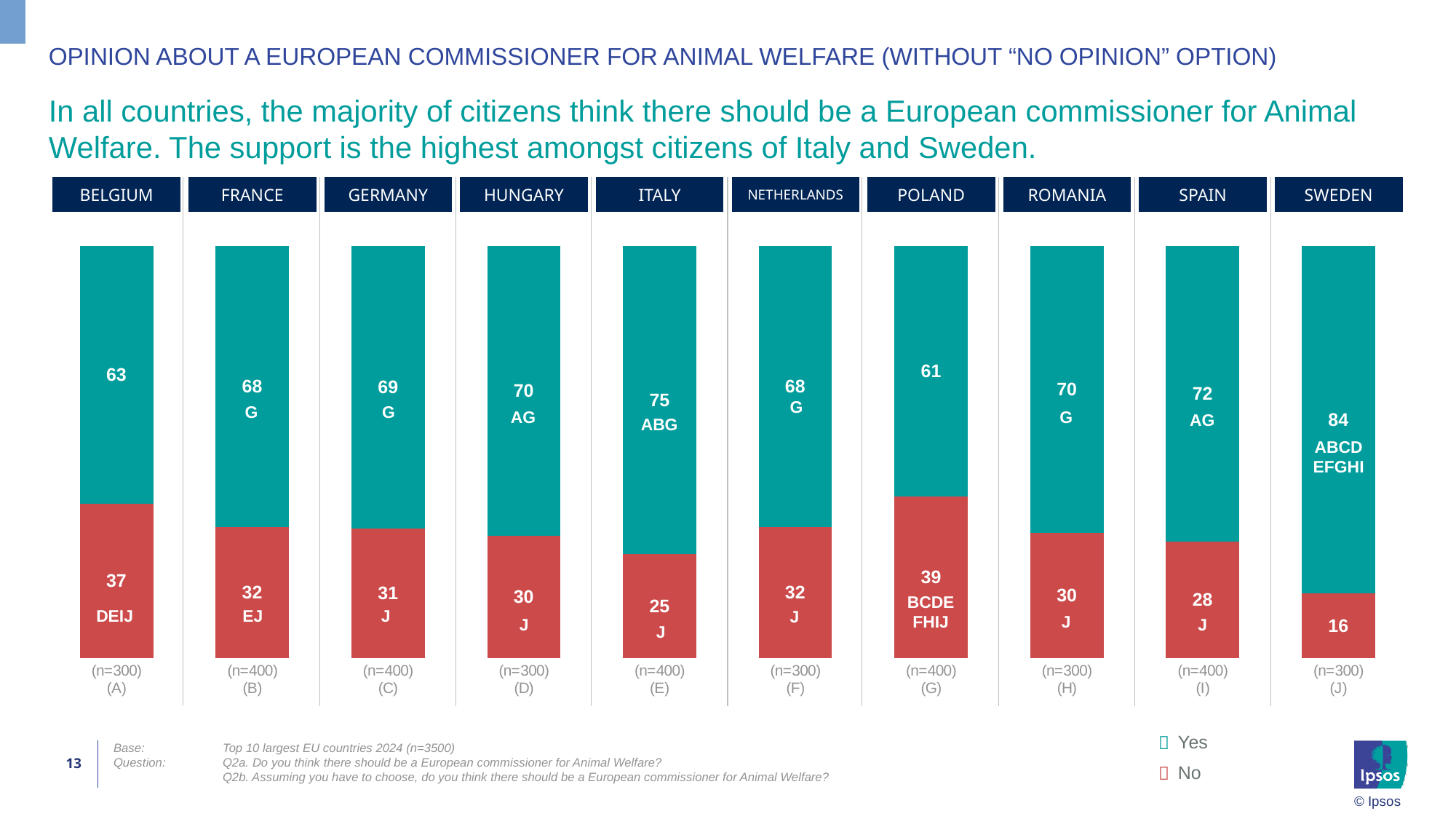
What is the 'Yes' value for Sweden? 84 What kind of chart is shown on the slide? Stacked bar chart How many countries are shown in the chart? 10 Which country has the lowest 'Yes' value? Poland Which country has the highest 'Yes' value? Sweden What is the 'Yes' value for Belgium? 63 What is the 'No' value for Poland? 39 Which is larger, the 'No' value for Belgium or the 'No' value for Spain? Belgium What is the total of the 'Yes' and 'No' values for Hungary? 100 How many series does the legend list? 2 Which country has the lowest 'No' value? Sweden What is the difference between the 'Yes' values for Italy and Belgium? 12